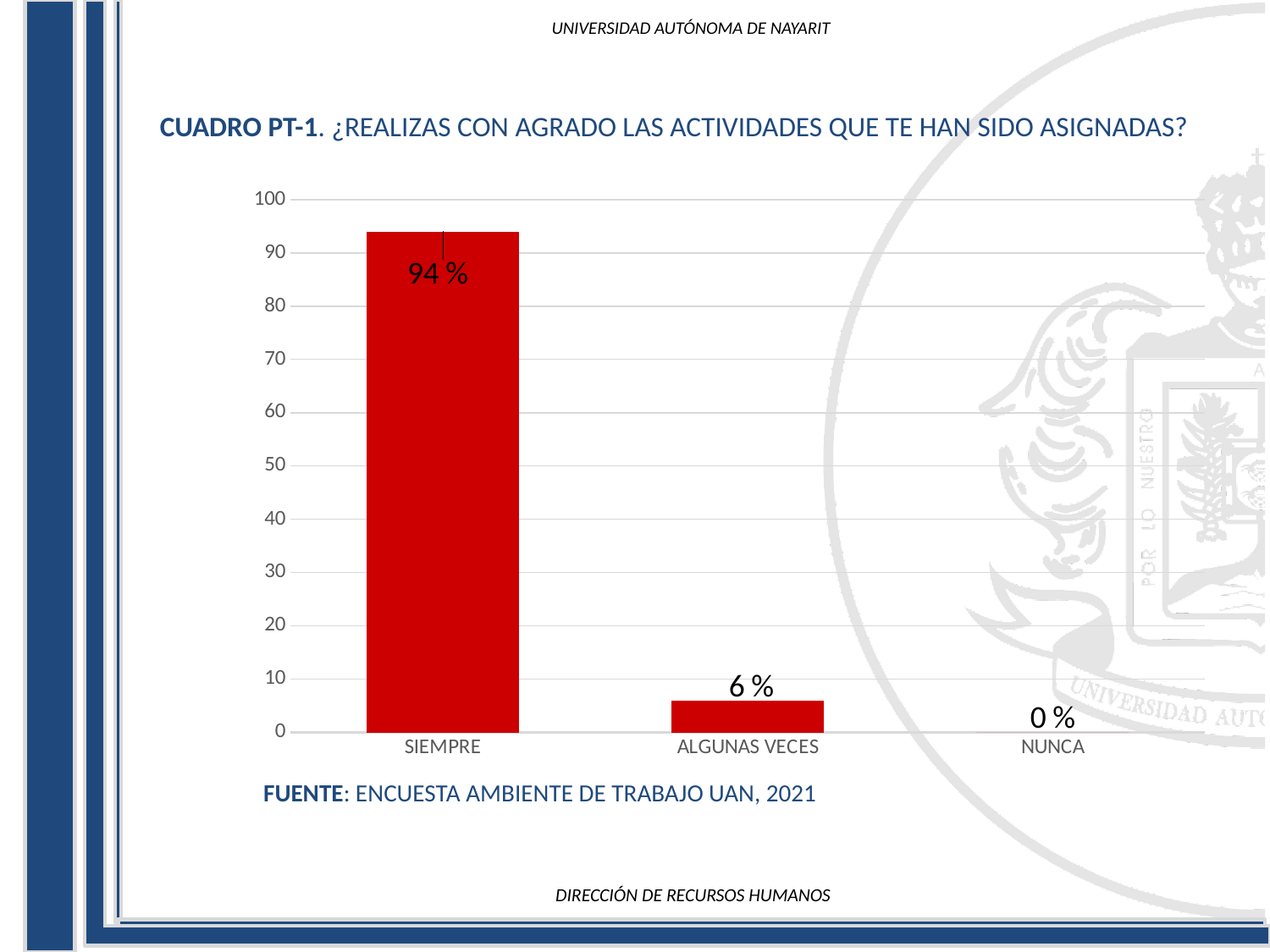
What is the value for NUNCA? 0 % Which is larger, the value for ALGUNAS VECES or the value for NUNCA? ALGUNAS VECES Which category has the lowest value? NUNCA What is the value for SIEMPRE? 94 % How many categories are shown on the x axis? 3 Which category has the highest value? SIEMPRE What is the difference between the values for SIEMPRE and ALGUNAS VECES? 88 % Is the value for SIEMPRE greater or less than 90? greater What colour are the bars in the chart? red Is the value for ALGUNAS VECES greater or less than 10? less What is the value for ALGUNAS VECES? 6 % What kind of chart is shown on the slide? bar chart